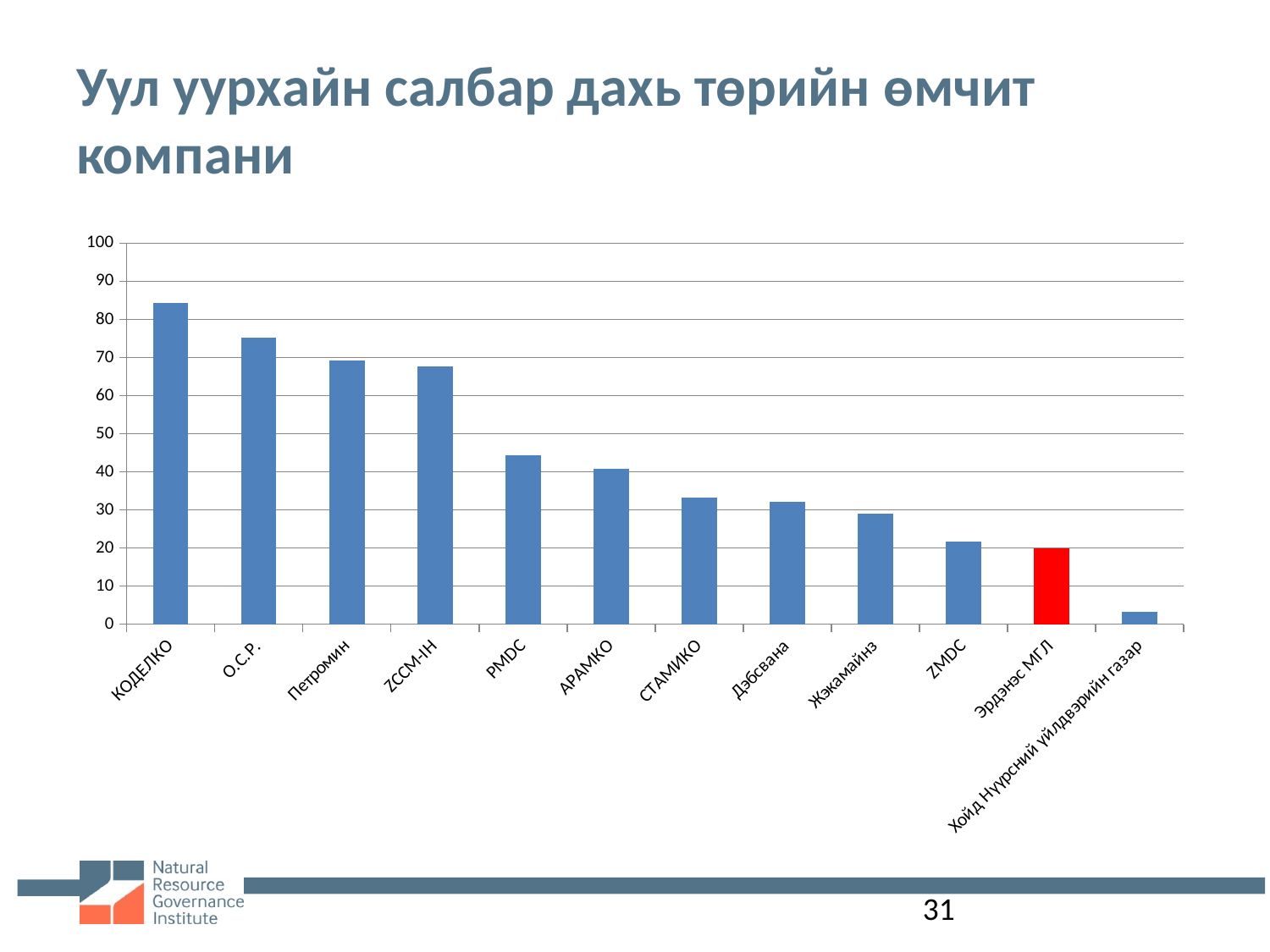
Is the value for PMDC greater or less than 50? less Do the bar values rise or fall from left to right along the x axis? fall Which company has the lowest bar in the chart? Хойд Нүүрсний үйлдвэрийн газар What kind of chart is shown on the slide? bar chart Which company's bar is coloured red instead of blue? Эрдэнэс МГЛ Is the value for Хойд Нүүрсний үйлдвэрийн газар greater or less than 10? less How many companies are shown on the x axis of the chart? 12 Which company has the highest bar in the chart? КОДЕЛКО Which has the larger value, Петромин or СТАМИКО? Петромин Is the value for O.C.P. greater or less than 70? greater